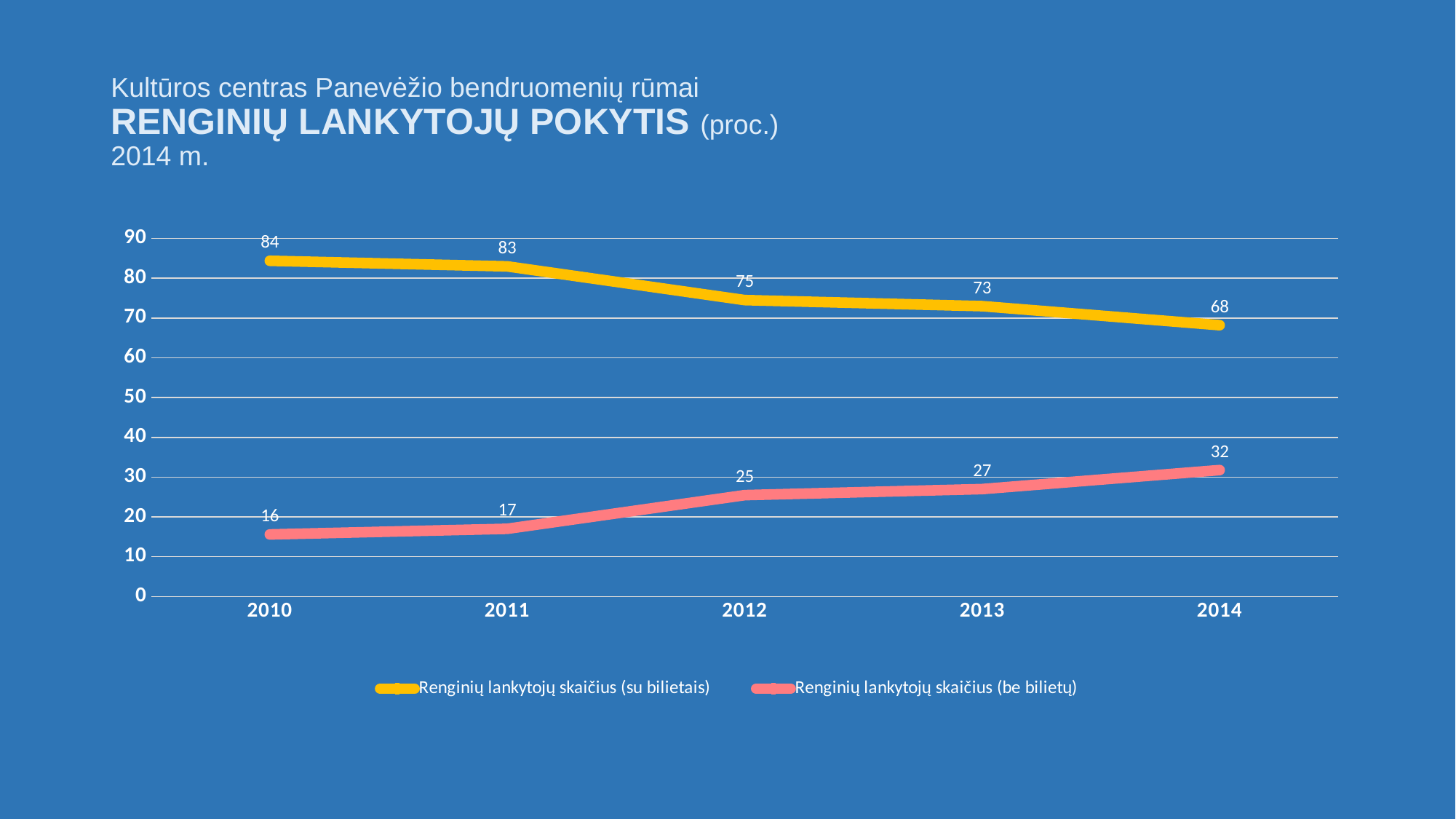
Does the 'Renginių lankytojų skaičius (su bilietais)' series rise or fall from 2010 to 2014? Fall What kind of chart is shown on the slide? Line chart What is the value for 'Renginių lankytojų skaičius (su bilietais)' in 2012? 75 What is the difference between the 'su bilietais' value and the 'be bilietų' value in 2014? 36 What colour is the line for 'Renginių lankytojų skaičius (be bilietų)'? Pink/red Which is larger in 2013: the 'su bilietais' value or the 'be bilietų' value? Renginių lankytojų skaičius (su bilietais) How many years are shown on the x axis? 5 What is the value for 'Renginių lankytojų skaičius (be bilietų)' in 2014? 32 In which year is 'Renginių lankytojų skaičius (su bilietais)' highest? 2010 How many series does the legend list? 2 In which year is 'Renginių lankytojų skaičius (be bilietų)' lowest? 2010 What is the value for 'Renginių lankytojų skaičius (su bilietais)' in 2010? 84